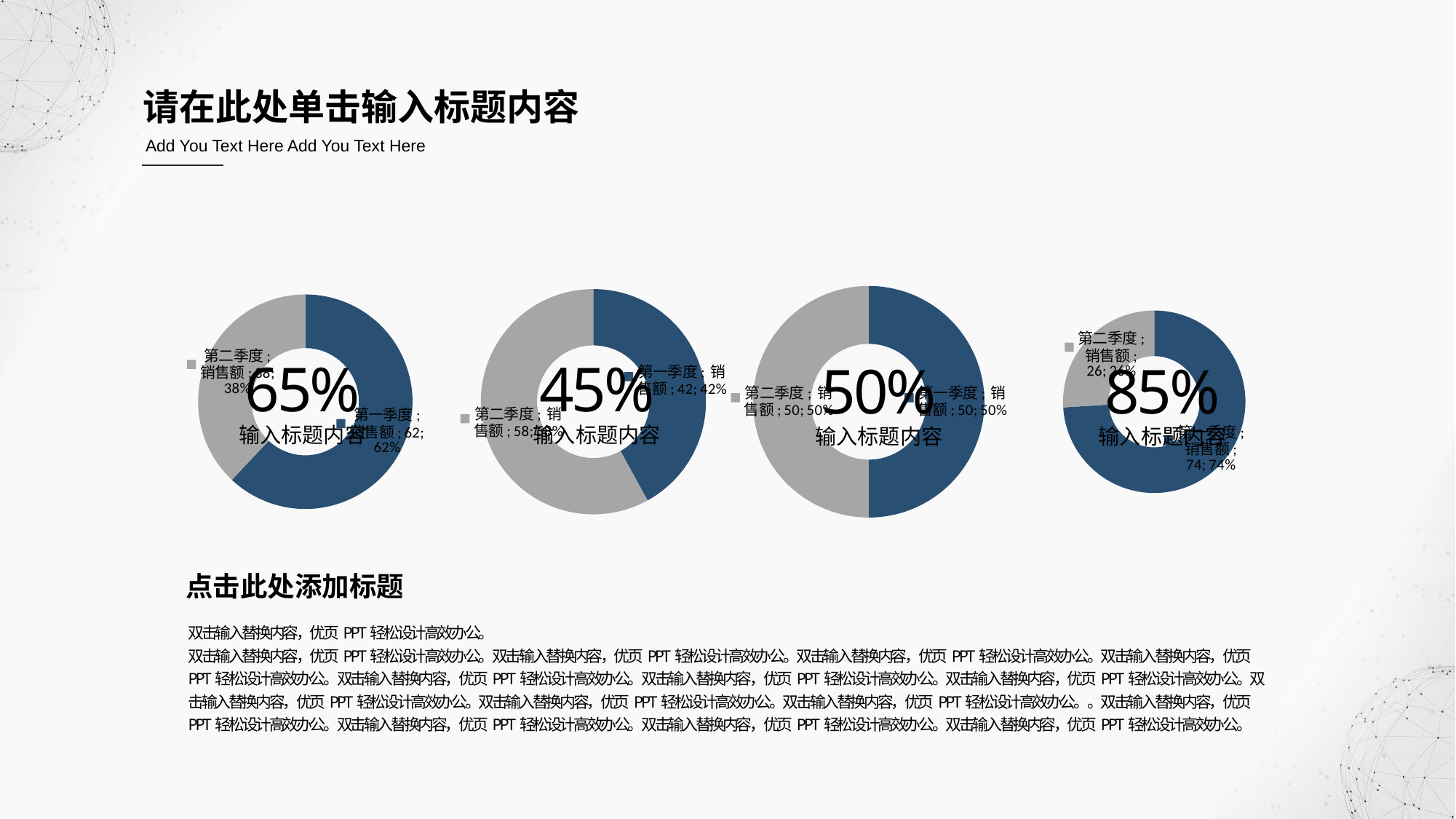
In the third doughnut chart from the left, what percentage is shown for 第二季度 (second quarter)? 50% In the second doughnut chart from the left, which quarter has the smaller share? 第一季度 In the rightmost doughnut chart, what is the value labelled for 第二季度 (second quarter)? 26; 26% How many doughnut charts are shown on the slide? 4 What type of chart is used for each of the four charts on the slide? Doughnut chart In the second doughnut chart from the left, what percentage is shown for 第一季度 (first quarter)? 42% In the leftmost doughnut chart, what percentage is shown for 第二季度 (second quarter)? 38% In the leftmost doughnut chart, which quarter has the larger share? 第一季度 In the rightmost doughnut chart, what percentage is shown for 第一季度 (first quarter)? 74% In the second doughnut chart from the left, what is the value labelled for 第二季度 (second quarter)? 58; 58% In the leftmost doughnut chart, what is the value labelled for 第一季度 (first quarter)? 62; 62% In the rightmost doughnut chart, what is the difference between the 第一季度 and 第二季度 percentages? 48%